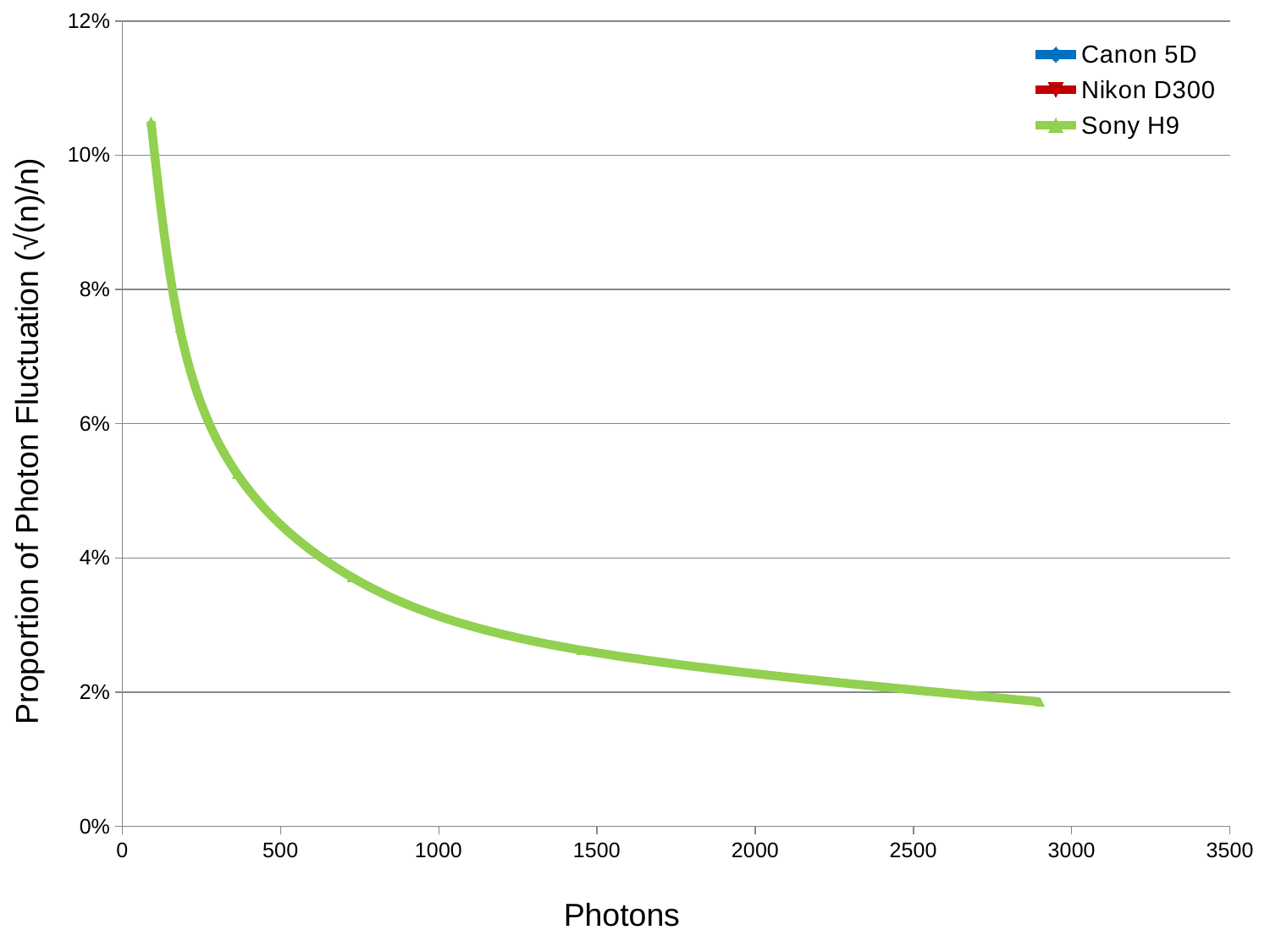
Do the plotted values rise or fall as the number of photons increases? fall Is the value of the visible curve at 200 photons greater or less than 6%? greater What is the title of the x axis? Photons Is the value of the visible curve at 1500 photons greater or less than 4%? less What kind of chart is shown on the slide? line chart Is the highest plotted value on the curve greater or less than 10%? greater Which series are listed in the legend? Canon 5D, Nikon D300, Sony H9 How many series does the legend list? 3